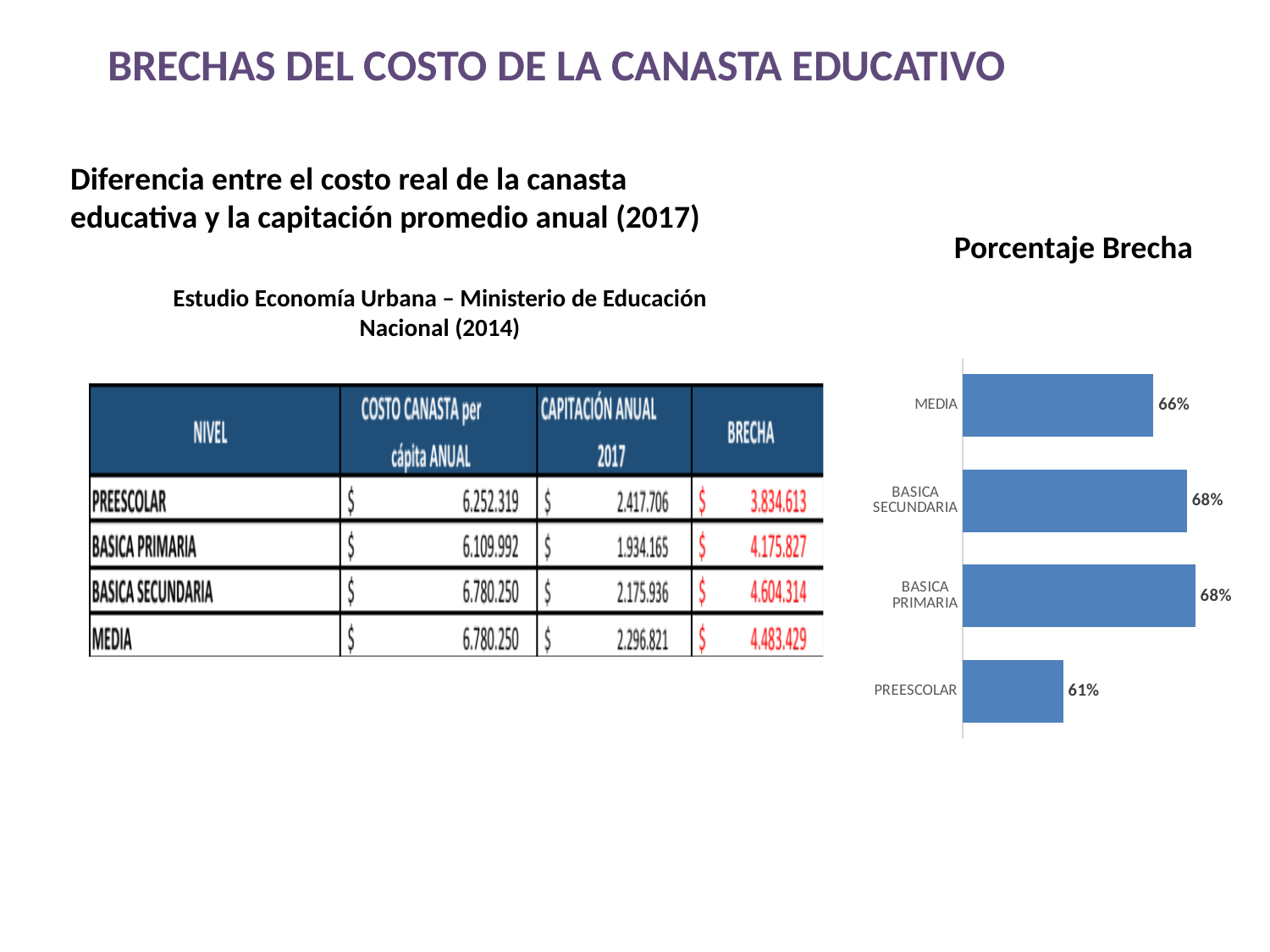
How many categories are shown in the Porcentaje Brecha chart? 4 What is the value for BASICA PRIMARIA in the Porcentaje Brecha chart? 68% What is the value for PREESCOLAR in the Porcentaje Brecha chart? 61% What is the difference between the values for MEDIA and PREESCOLAR in the Porcentaje Brecha chart? 5% What is the difference between the values for BASICA PRIMARIA and PREESCOLAR in the Porcentaje Brecha chart? 7% What is the title of the chart on the slide? Porcentaje Brecha What is the value for BASICA SECUNDARIA in the Porcentaje Brecha chart? 68% In the Porcentaje Brecha chart, which is larger: the value for MEDIA or the value for PREESCOLAR? MEDIA What is the value for MEDIA in the Porcentaje Brecha chart? 66% What kind of chart is the Porcentaje Brecha chart? Bar chart Which category has the lowest value in the Porcentaje Brecha chart? PREESCOLAR In the Porcentaje Brecha chart, which is larger: the value for BASICA PRIMARIA or the value for MEDIA? BASICA PRIMARIA